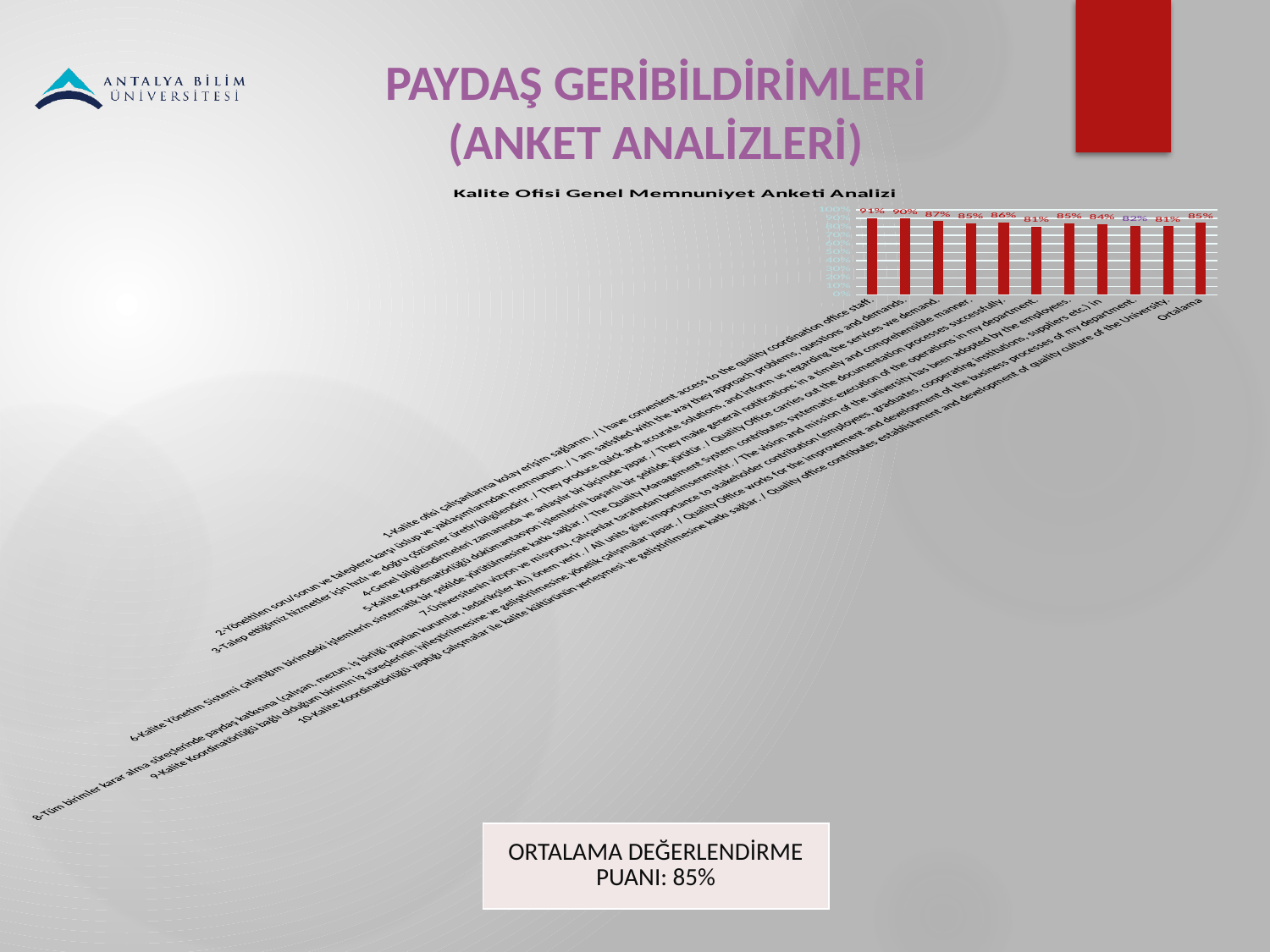
What is the value of the 'Ortalama' bar in the chart? 85% What is the highest value shown in the chart? 91% What is the lowest value shown in the chart? 81% What is the title of the chart on the slide? Kalite Ofisi Genel Memnuniyet Anketi Analizi How many bars are plotted in the chart? 11 Which is larger, the value of the first bar or the value of the 'Ortalama' bar? the first bar What is the value of the second bar (item 2, 'Yönetilen soru/sorun ve taleplere...')? 90% What type of chart is shown on the slide? bar chart What is the value of the third bar (item 3, 'Talep ettiğimiz hizmetler...')? 87% What is the difference between the first bar (91%) and the 'Ortalama' bar (85%)? 6 percentage points What is the value of the first bar (item 1, 'Kalite ofisi çalışanlarına kolay erişim sağlarım...')? 91% What is the maximum value shown on the vertical axis of the chart? 100%